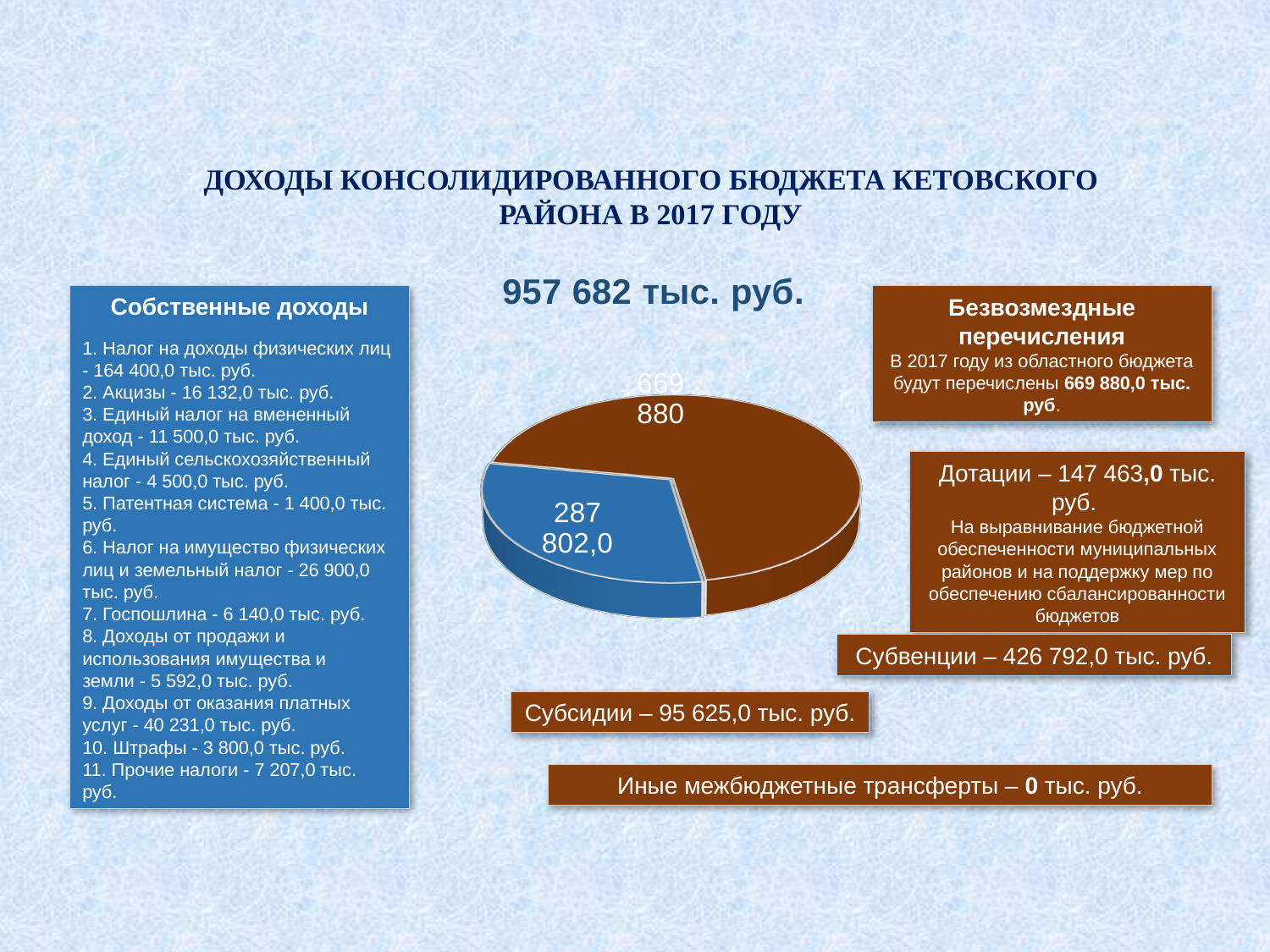
What value is labelled on the blue slice of the pie chart? 287 802,0 Which slice of the pie chart is the largest? the brown slice (669 880) What value is labelled on the brown slice of the pie chart? 669 880 Is the value of the blue slice of the pie chart greater or less than 300 000? less What colour is the slice of the pie chart labelled 287 802,0? blue Which slice of the pie chart is the smallest? the blue slice (287 802,0) What is the difference between the values of the brown slice and the blue slice in the pie chart? 382 078,0 What kind of chart is shown on the slide? pie chart What is the title of the slide containing the pie chart? ДОХОДЫ КОНСОЛИДИРОВАННОГО БЮДЖЕТА КЕТОВСКОГО РАЙОНА В 2017 ГОДУ Which is larger in the pie chart: the blue slice or the brown slice? the brown slice What total value is shown above the pie chart? 957 682 тыс. руб. How many slices does the pie chart have? 2